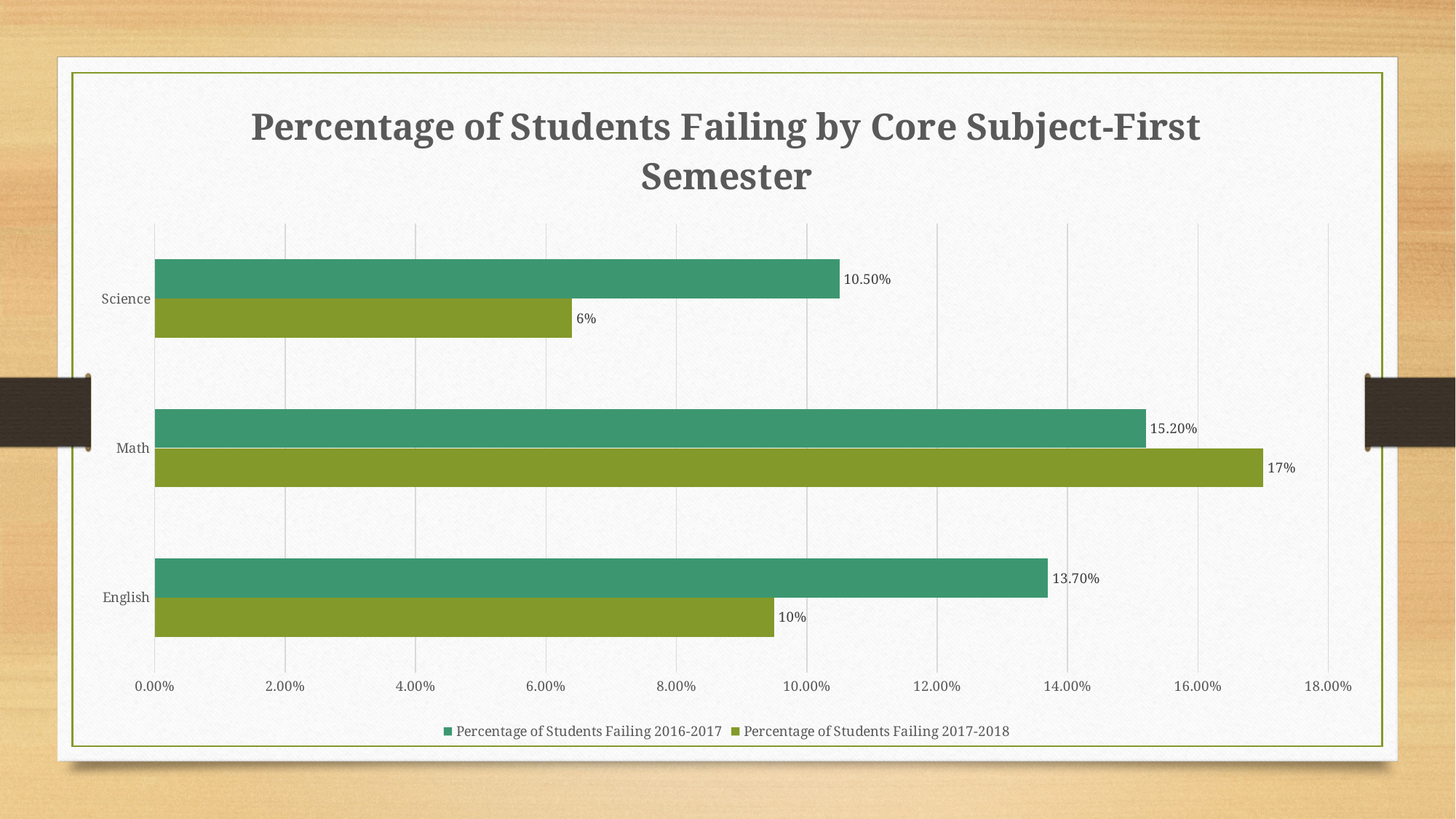
Is the percentage of students failing Math in 2017-2018 greater or less than 16.00%? greater What is the percentage of students failing Science in 2016-2017? 10.50% What is the percentage of students failing Science in 2017-2018? 6% Which subject has the highest percentage of students failing in 2016-2017? Math Which is larger: the percentage of students failing English in 2016-2017 or in 2017-2018? 2016-2017 What is the difference between the 2016-2017 failing percentages for Math and Science? 4.70% How many series does the legend list? 2 What type of chart is shown on the slide? Bar chart How many subjects are shown on the chart? 3 What is the percentage of students failing Math in 2017-2018? 17% Which subject has the lowest percentage of students failing in 2017-2018? Science What is the percentage of students failing English in 2016-2017? 13.70%